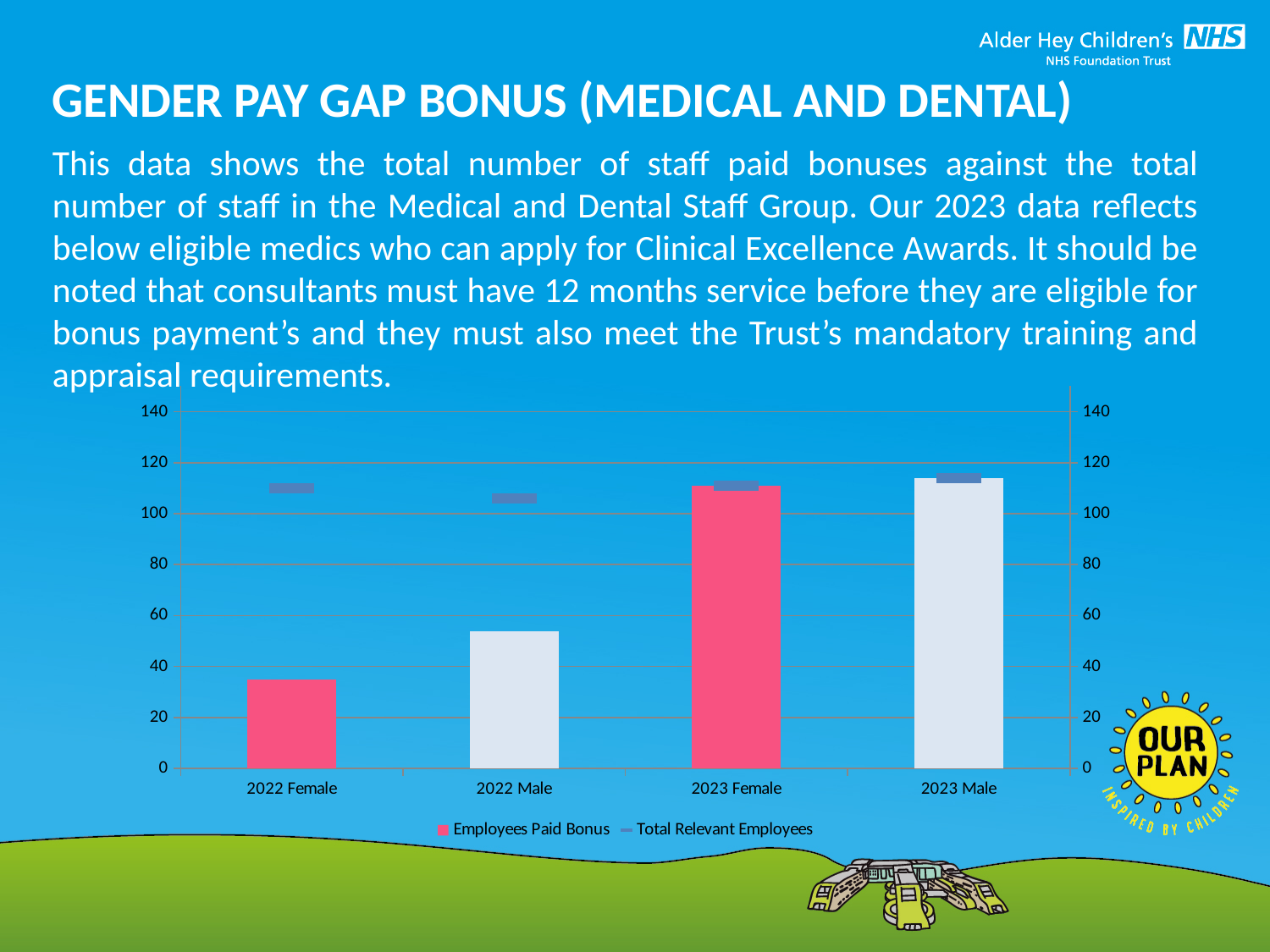
How many series does the chart legend list? 2 How many categories are shown on the x axis of the chart? 4 Is the Employees Paid Bonus value for 2023 Male greater or less than 120? less Is the Employees Paid Bonus value for 2022 Male greater or less than 60? less What kind of chart is shown on the slide? bar chart Is the Employees Paid Bonus value for 2022 Female greater or less than 40? less Do the Employees Paid Bonus values generally rise or fall from 2022 Female to 2023 Male along the x axis? rise Which has the larger Employees Paid Bonus value, 2022 Male or 2022 Female? 2022 Male Which category has the lowest value for Employees Paid Bonus? 2022 Female What are the two series named in the chart legend? Employees Paid Bonus and Total Relevant Employees